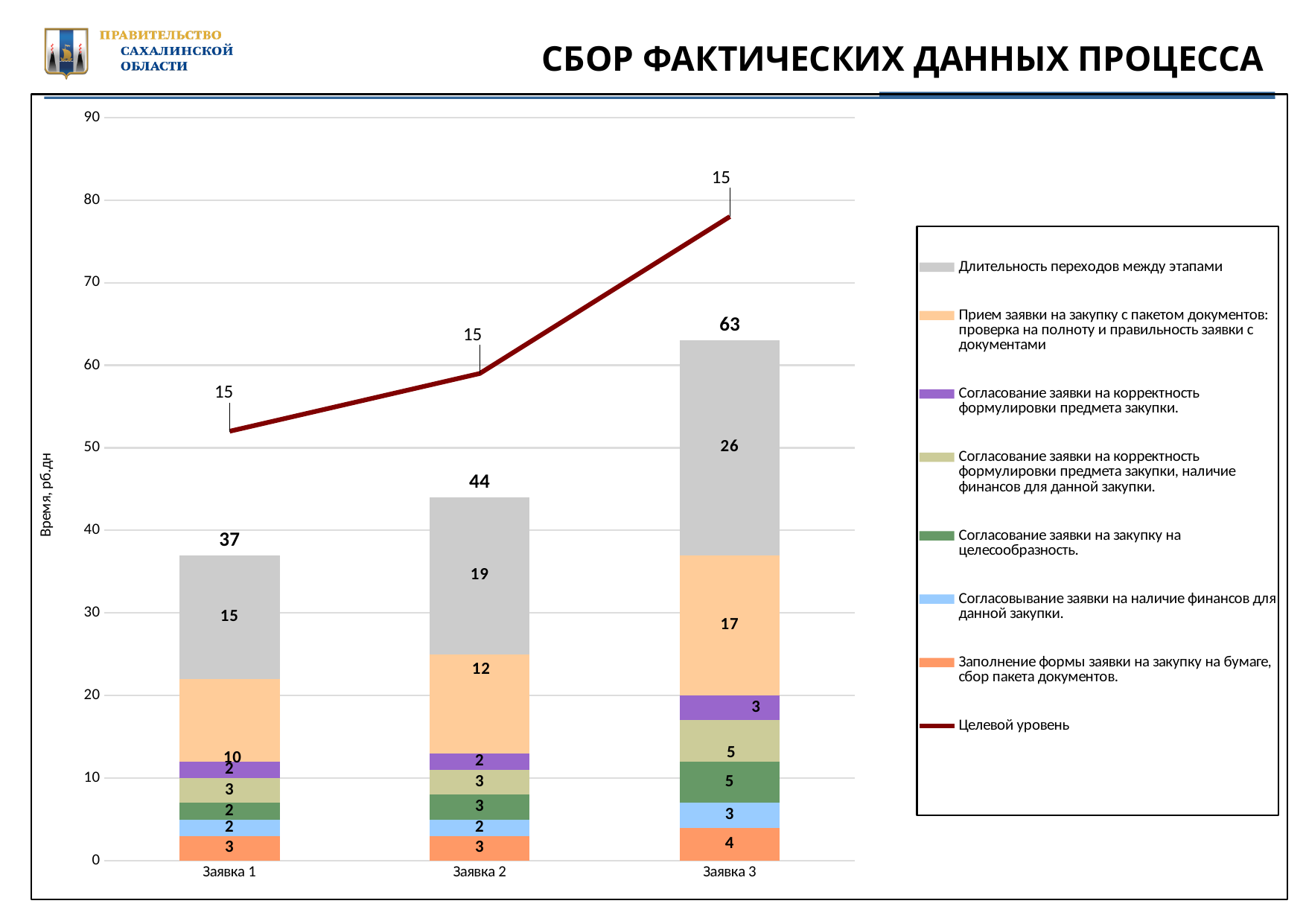
What kind of chart is shown on the slide? stacked bar chart with a line What is the value of the 'Прием заявки на закупку с пакетом документов' segment for Заявка 3? 17 How many categories are shown on the x axis? 3 What is the value of the 'Длительность переходов между этапами' segment for Заявка 2? 19 What is the total value of the stacked bar for Заявка 3? 63 Which category has the highest total bar value? Заявка 3 Do the total bar values rise or fall from Заявка 1 to Заявка 3? rise Which is larger: the 'Согласование заявки на закупку на целесообразность' segment for Заявка 1 or for Заявка 3? Заявка 3 What is the label of the y axis? Время, рб.дн Which category has the lowest total bar value? Заявка 1 What is the difference between the total bar values of Заявка 3 and Заявка 1? 26 How many series does the legend list? 8